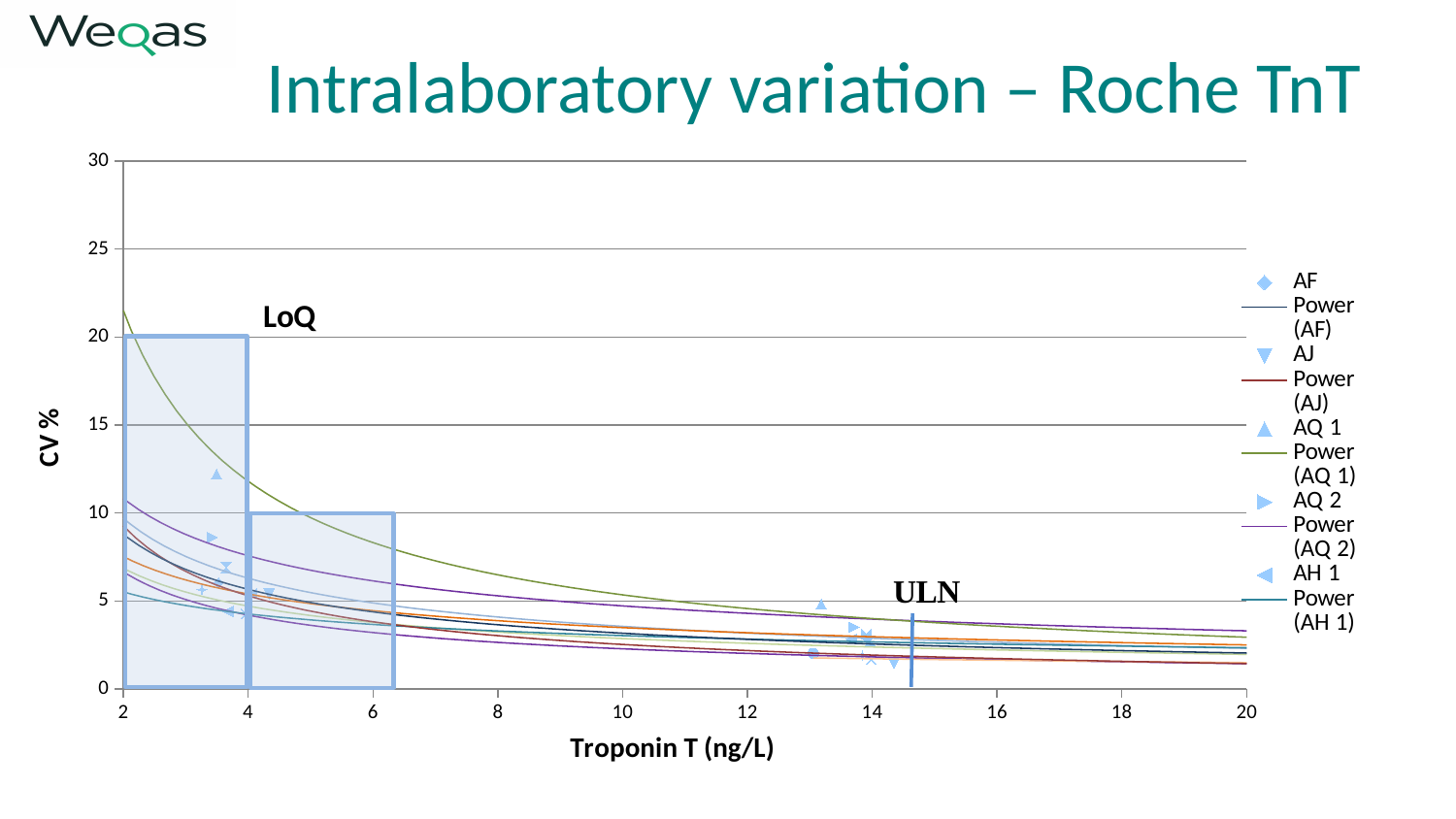
Is the AQ 1 data point near Troponin T = 3.5 ng/L greater or less than 10 CV %? greater Which trendline has the highest CV % at Troponin T = 2 ng/L? Power (AQ 1) Is the value of the Power (AQ 1) trendline at Troponin T = 20 ng/L greater or less than 5? less What kind of chart is shown on the slide? Scatter chart with trendlines How many entries does the legend list? 10 Is the value of the Power (AQ 1) trendline at Troponin T = 2 ng/L greater or less than 15? greater What is the maximum value shown on the CV % axis? 30 Do the trendlines rise or fall as Troponin T increases along the x axis? Fall What is the title of the chart? Intralaboratory variation – Roche TnT What is the label of the x axis? Troponin T (ng/L) At Troponin T = 20 ng/L, which trendline is higher: Power (AQ 2) or Power (AJ)? Power (AQ 2)